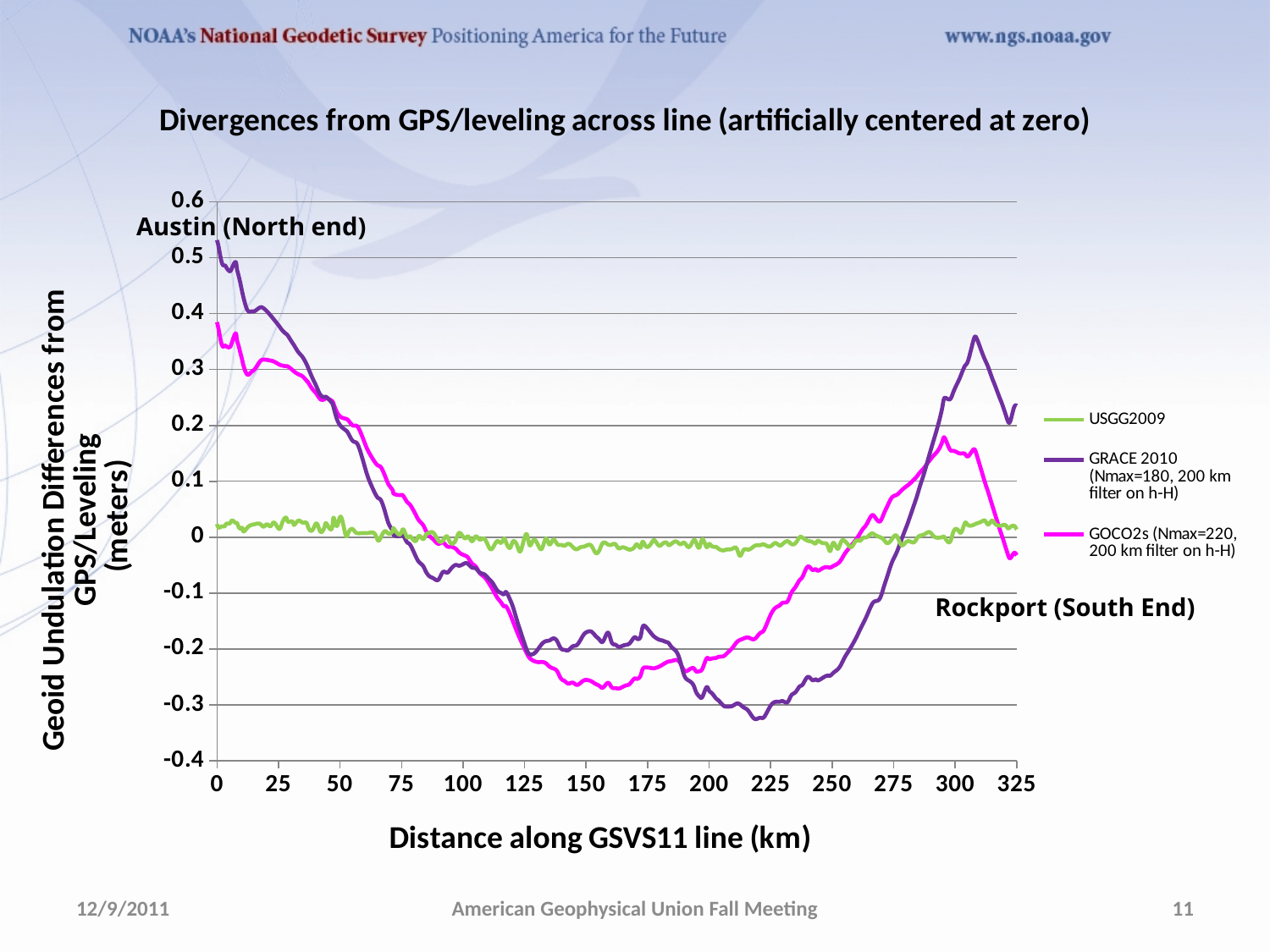
At 200 km, which series has the lower value, GRACE 2010 or GOCO2s? GRACE 2010 Which series reaches the lowest value on the chart? GRACE 2010 Is the value for USGG2009 at 150 km greater or less than 0.1? less What kind of chart is shown on the slide? line chart Is the value for GOCO2s at 150 km greater or less than -0.2? less How many series does the legend list? 3 Is the value for GRACE 2010 at 0 km greater or less than 0.4? greater Does the GRACE 2010 series rise or fall between 0 km and 100 km? fall What is the label of the x axis? Distance along GSVS11 line (km) What is the title of the chart? Divergences from GPS/leveling across line (artificially centered at zero)